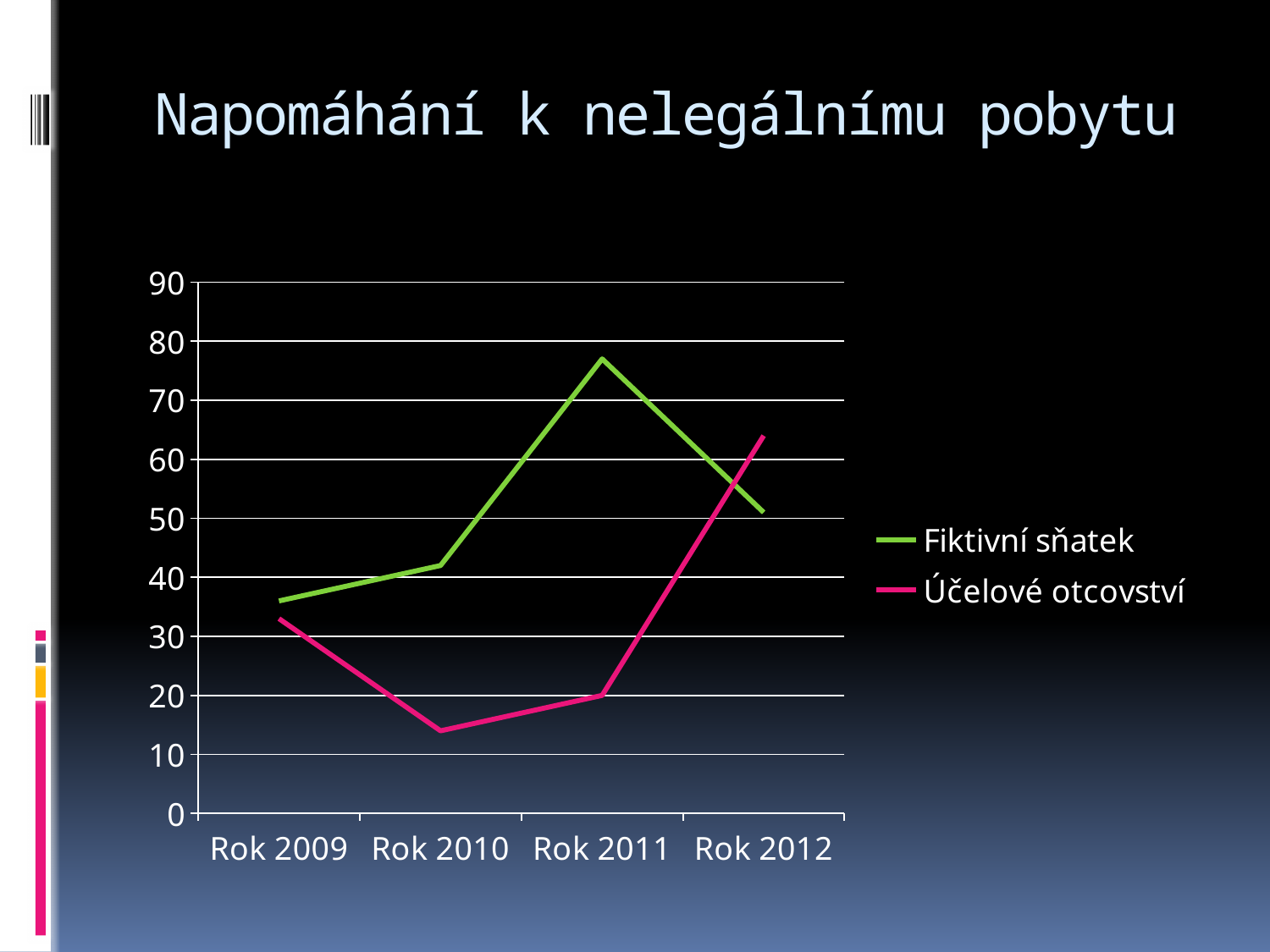
How many years are shown on the x axis? 4 Is the value for Účelové otcovství in Rok 2010 greater or less than 20? less What is the title of the chart on the slide? Napomáhání k nelegálnímu pobytu In which year does the Účelové otcovství series reach its lowest value? Rok 2010 How many series does the legend list? 2 Is the value for Fiktivní sňatek in Rok 2009 greater or less than 30? greater In which year does the Fiktivní sňatek series reach its highest value? Rok 2011 What kind of chart is shown on the slide? line chart In which year does the Účelové otcovství series reach its highest value? Rok 2012 In Rok 2012, which series has the larger value, Fiktivní sňatek or Účelové otcovství? Účelové otcovství Is the value for Fiktivní sňatek in Rok 2011 greater or less than 70? greater Does the Účelové otcovství series rise or fall between Rok 2011 and Rok 2012? rise